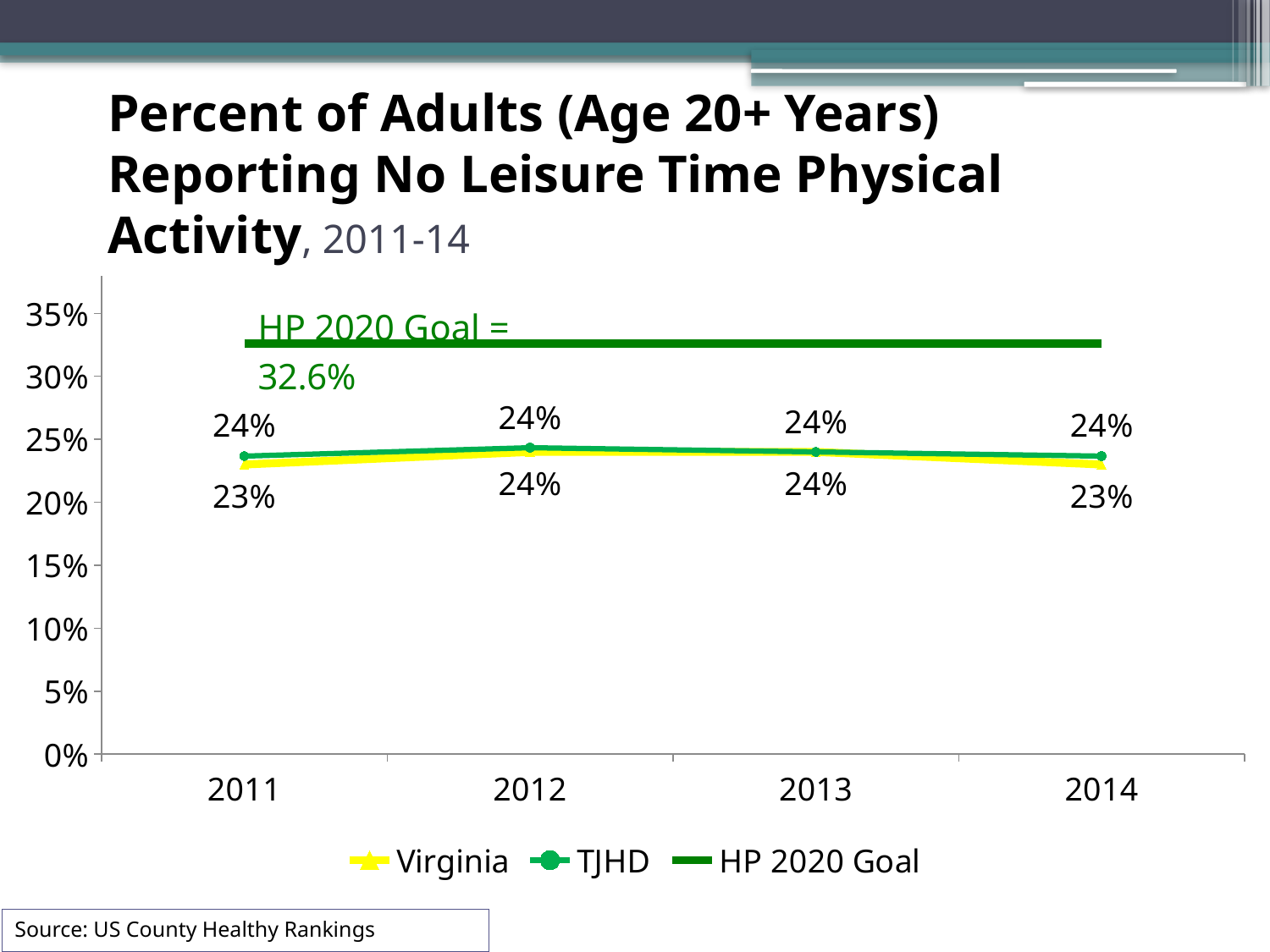
What is the Virginia value for 2014? 23% How many years are plotted on the x axis? 4 In 2011, which is larger, the TJHD value or the Virginia value? TJHD What source is cited for the chart data? US County Healthy Rankings What is the difference between the TJHD value and the Virginia value in 2014? 1% What kind of chart is shown on the slide? Line chart What is the TJHD value for 2014? 24% What is the Virginia value for 2011? 23% What is the TJHD value for 2012? 24% Is the Virginia value for 2012 greater or less than 30%? less What is the HP 2020 Goal value shown on the chart? 32.6% How many series does the legend list? 3